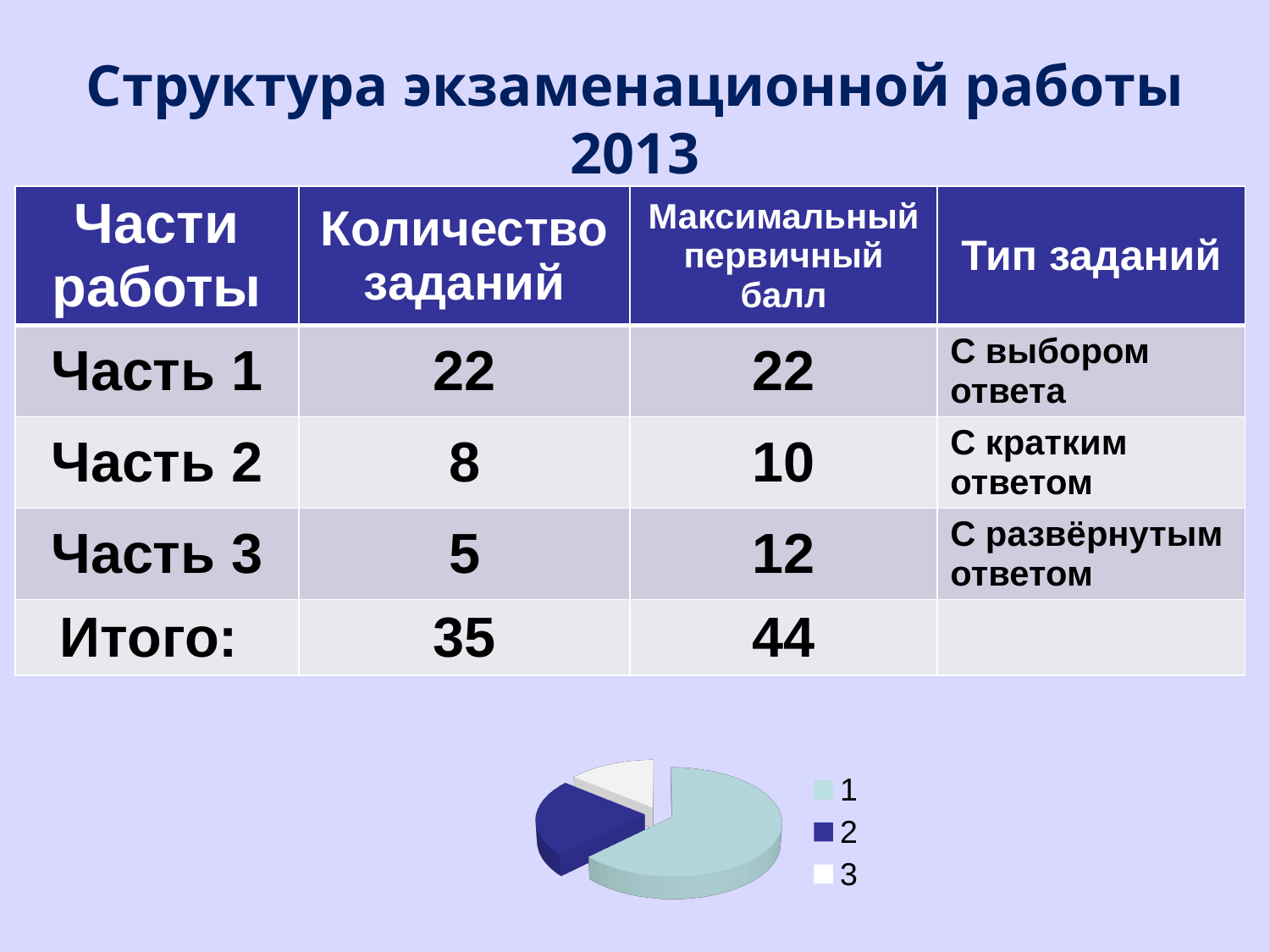
Does the slice for category 1 take up more or less than half of the pie chart? more How many entries does the legend of the pie chart list? 3 Which category has the smallest slice in the pie chart? 3 What colour is the slice for category 2 in the pie chart? dark blue In the pie chart, which slice is larger, category 1 or category 2? 1 What kind of chart is shown at the bottom of the slide? pie chart In the pie chart, which slice is larger, category 2 or category 3? 2 What are the legend entries of the pie chart? 1, 2, 3 Which category has the largest slice in the pie chart? 1 How many slices does the pie chart have? 3